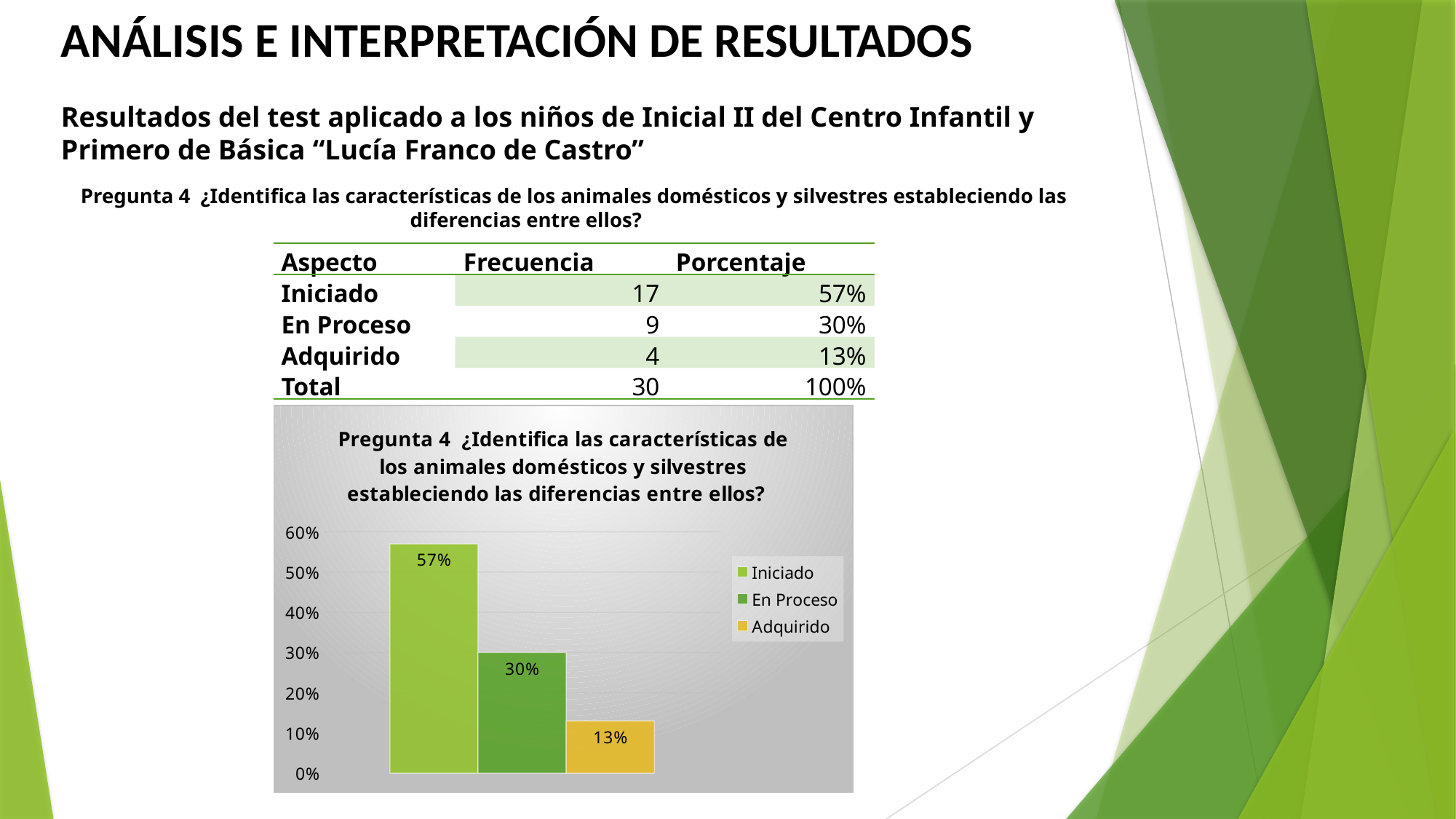
What kind of chart is shown on the slide? Bar chart Which is larger, the value for En Proceso or the value for Adquirido? En Proceso What is the difference between the values for Iniciado and En Proceso? 27% How many series does the legend list? 3 What is the value for Adquirido in the chart? 13% Is the value for Iniciado greater or less than 50%? greater Which category has the highest value in the chart? Iniciado Which category has the lowest value in the chart? Adquirido What is the value for En Proceso in the chart? 30% What is the difference between the values for En Proceso and Adquirido? 17% What colour is the bar for Adquirido in the chart? Yellow What is the value for Iniciado in the chart? 57%